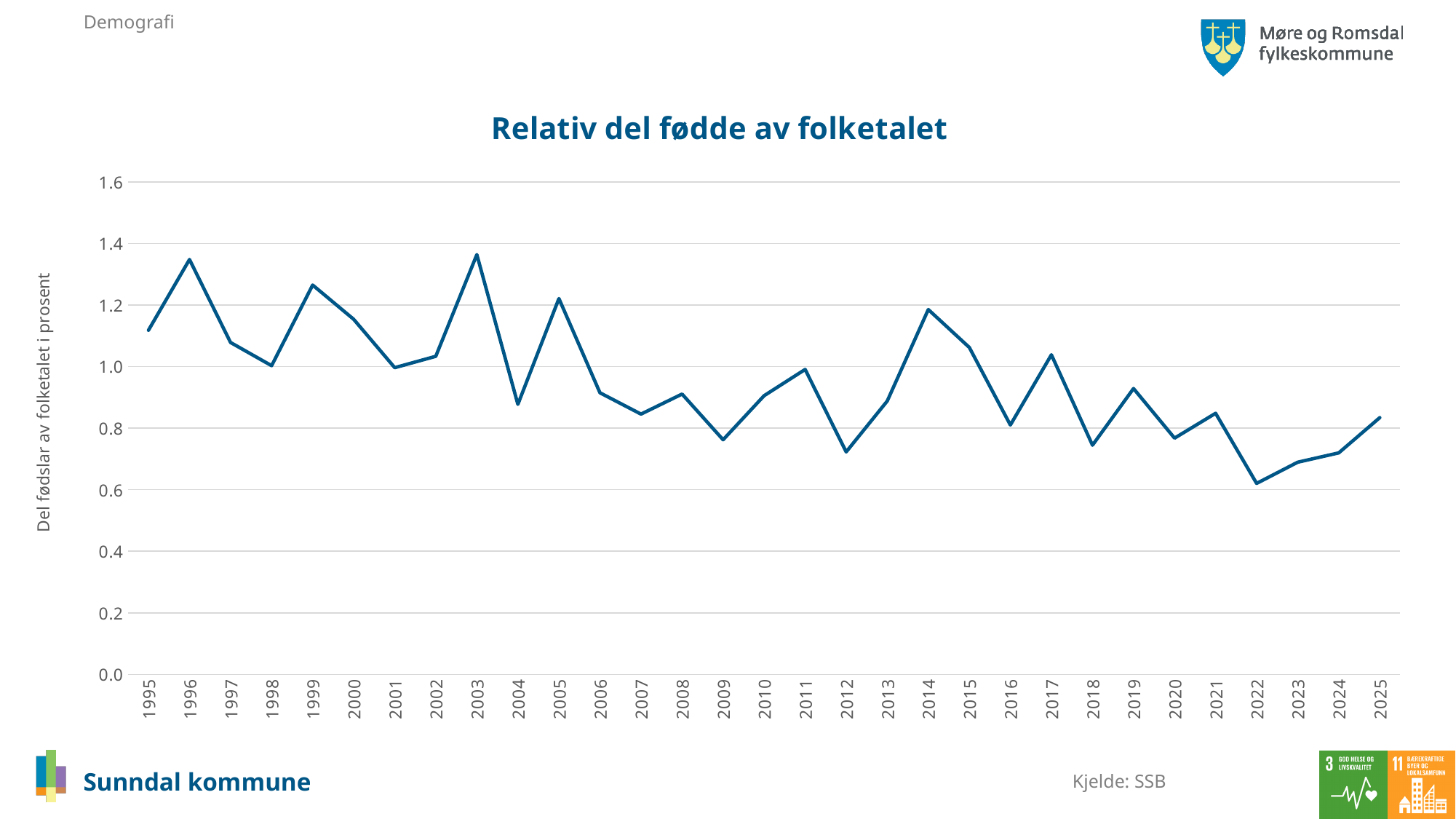
Which is larger, the value for 2014 or the value for 2016? 2014 What kind of chart is shown on the slide? line chart What is the title of the chart? Relativ del fødde av folketalet Which is larger, the value for 2003 or the value for 2004? 2003 Is the value for 2014 greater or less than 1.0? greater Which year has the lowest value? 2022 What is the label on the vertical axis? Del fødslar av folketalet i prosent How many years are plotted along the x axis? 31 Overall, do the values rise or fall from 1995 to 2025? fall Is the value for 2012 greater or less than 0.8? less Is the value for 2022 greater or less than 0.8? less